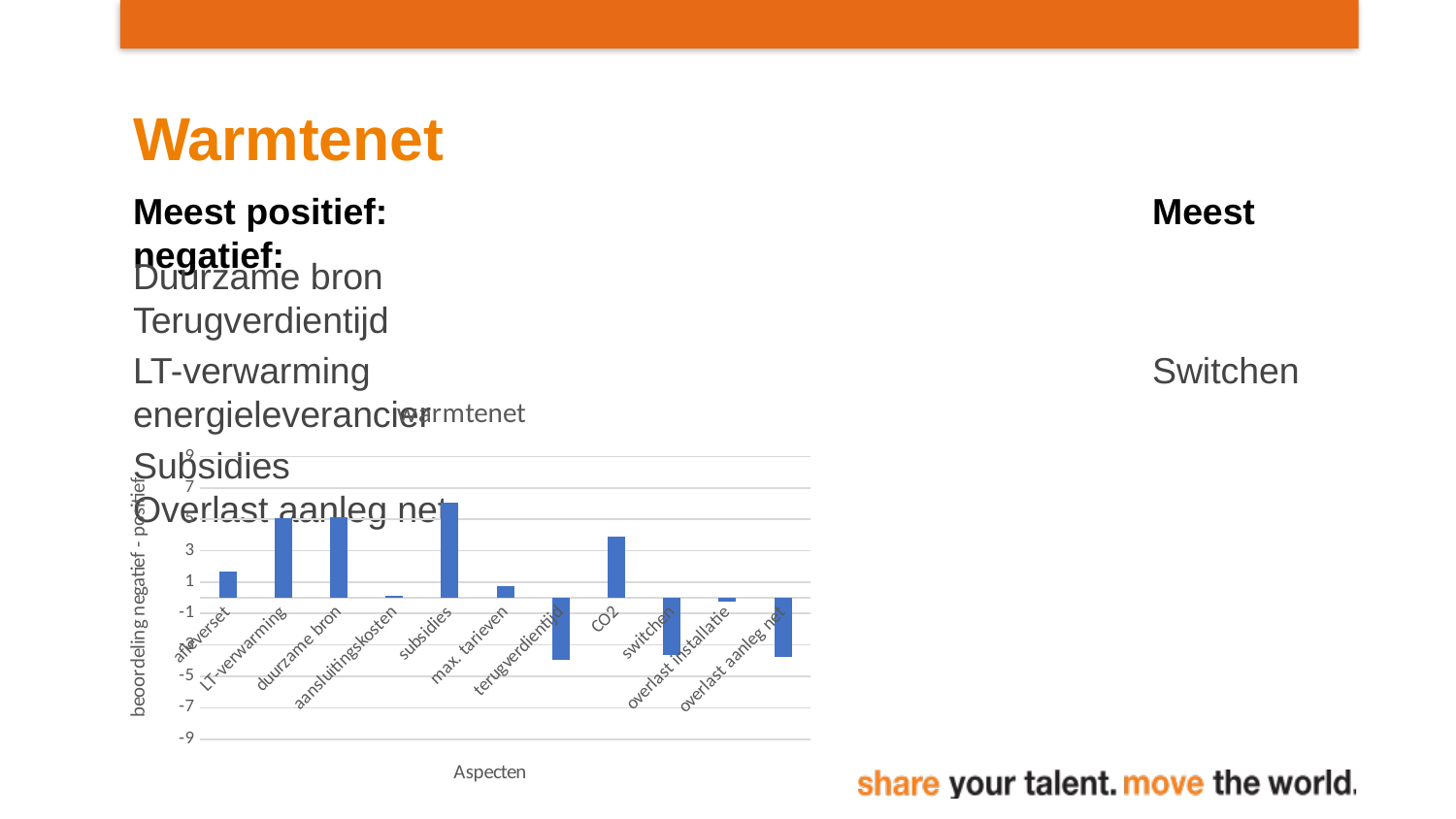
What is the label of the x axis of the chart? Aspecten What is the title of the chart? warmtenet Is the value for subsidies greater or less than 5? greater Which is larger, the value for LT-verwarming or the value for CO2? LT-verwarming Is the value for afleverset greater or less than 1? greater What kind of chart is shown on the slide? bar chart Is the value for CO2 greater or less than 5? less How many categories are plotted on the x axis of the chart? 11 Which category has the highest value in the chart? subsidies Which is larger, the value for subsidies or the value for CO2? subsidies Which is larger, the value for afleverset or the value for max. tarieven? afleverset